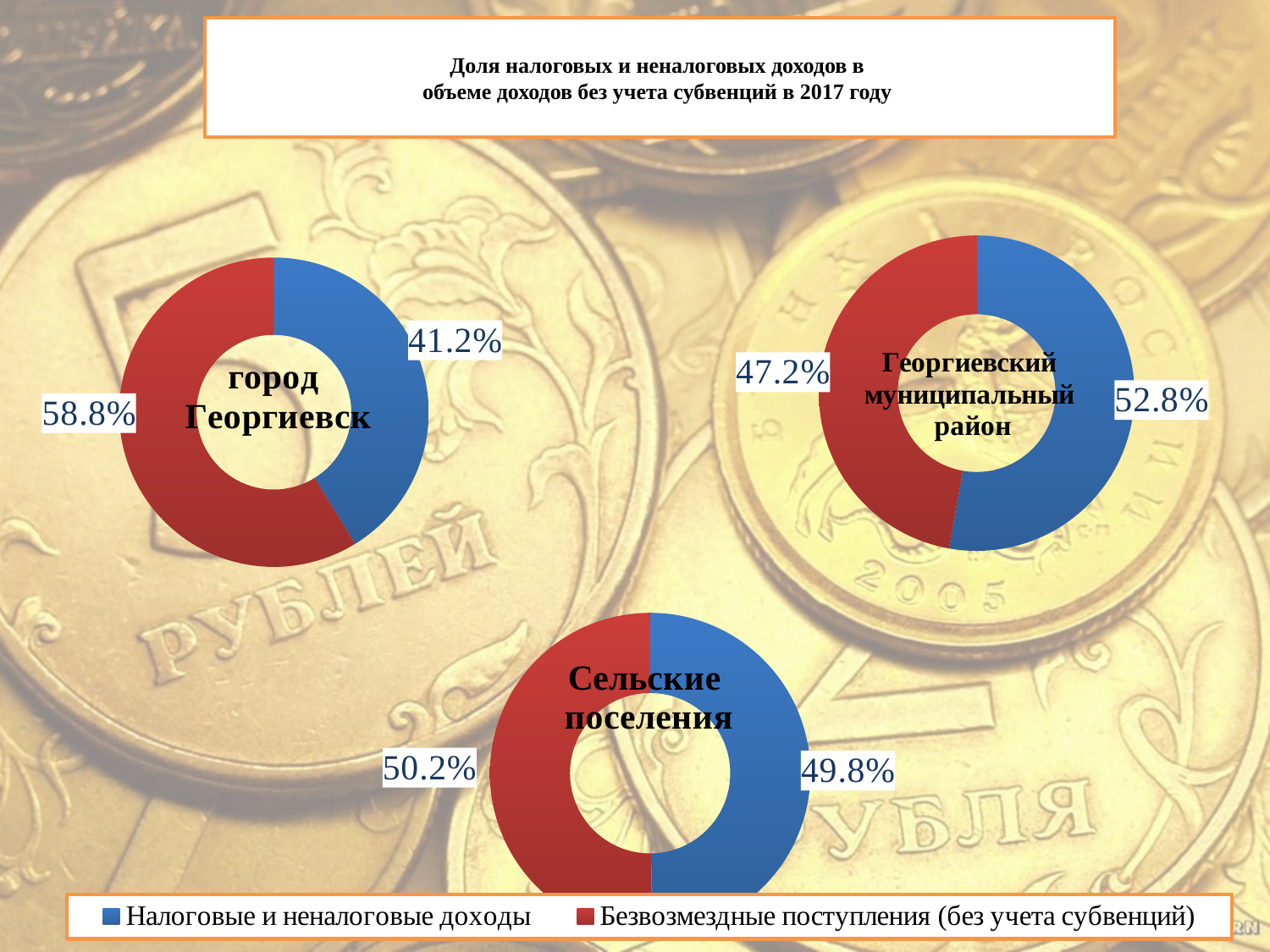
In the "Георгиевский муниципальный район" chart, which category has the smaller share? Безвозмездные поступления (без учета субвенций) In the "Георгиевский муниципальный район" chart, what share is shown for "Безвозмездные поступления (без учета субвенций)"? 47.2% In the "город Георгиевск" chart, what is the difference between the two shares? 17.6% In the "город Георгиевск" chart, what share is shown for "Налоговые и неналоговые доходы"? 41.2% In the "Георгиевский муниципальный район" chart, what share is shown for "Налоговые и неналоговые доходы"? 52.8% In the "Сельские поселения" chart, what share is shown for "Налоговые и неналоговые доходы"? 49.8% What kind of chart is used on this slide? Doughnut (pie) chart Which colour represents "Налоговые и неналоговые доходы" in the legend? Blue In the "город Георгиевск" chart, what share is shown for "Безвозмездные поступления (без учета субвенций)"? 58.8% In the "Сельские поселения" chart, what share is shown for "Безвозмездные поступления (без учета субвенций)"? 50.2% How many series does the legend list? 2 In the "город Георгиевск" chart, which category has the larger share? Безвозмездные поступления (без учета субвенций)